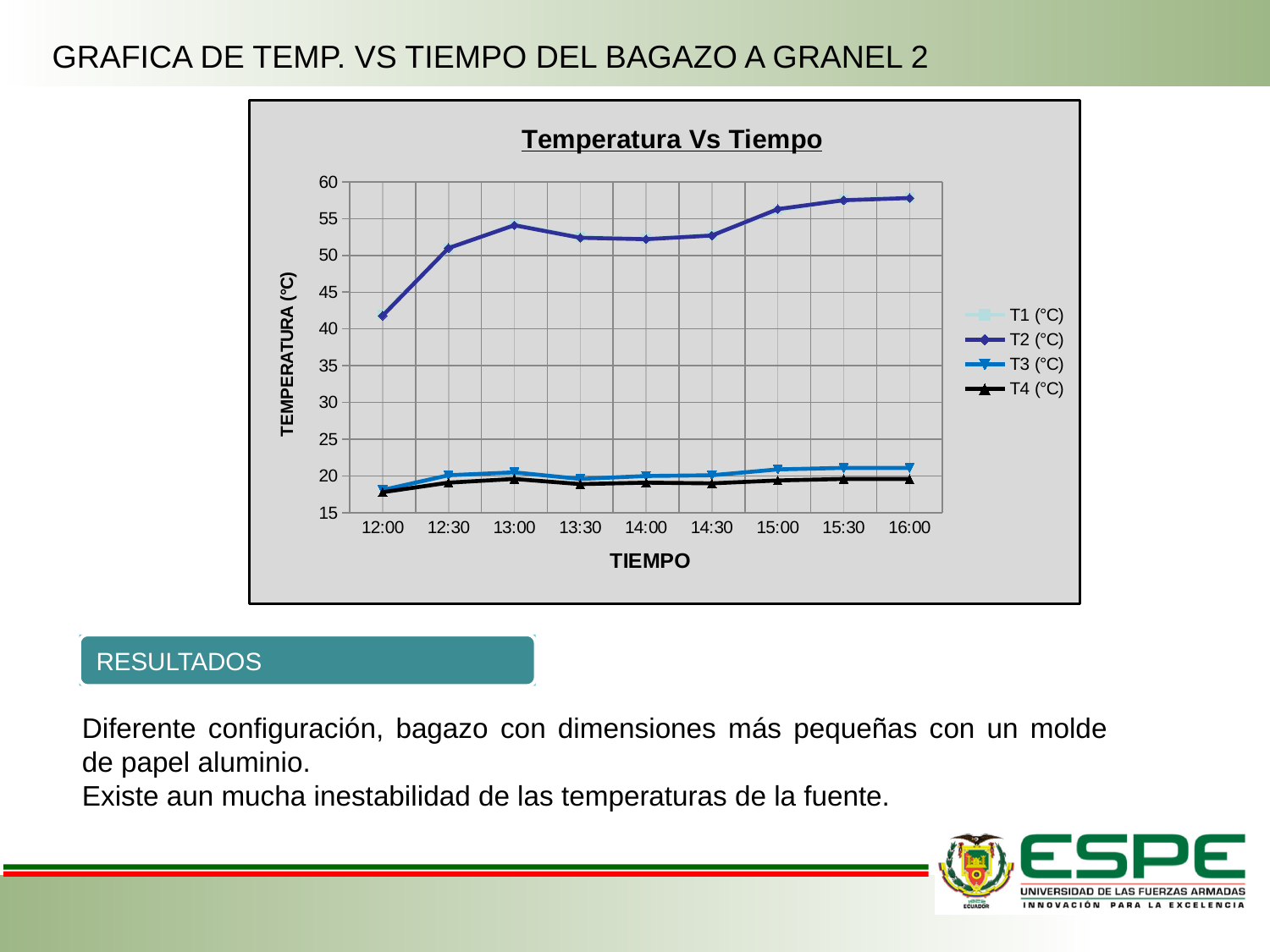
How many time points are plotted along the x axis? 9 Is the value of T2 (°C) at 16:00 greater or less than 55? greater What kind of chart is shown on the slide? line chart Is the value of T2 (°C) at 12:00 greater or less than 40? greater Does the T2 (°C) series overall rise or fall from 12:00 to 16:00? rise Is the value of T3 (°C) at 16:00 greater or less than 25? less Which series has the lowest temperature values throughout the chart? T4 (°C) Which is larger, the value of T2 (°C) at 12:00 or at 13:00? 13:00 What is the title of the chart? Temperatura Vs Tiempo How many series does the legend list? 4